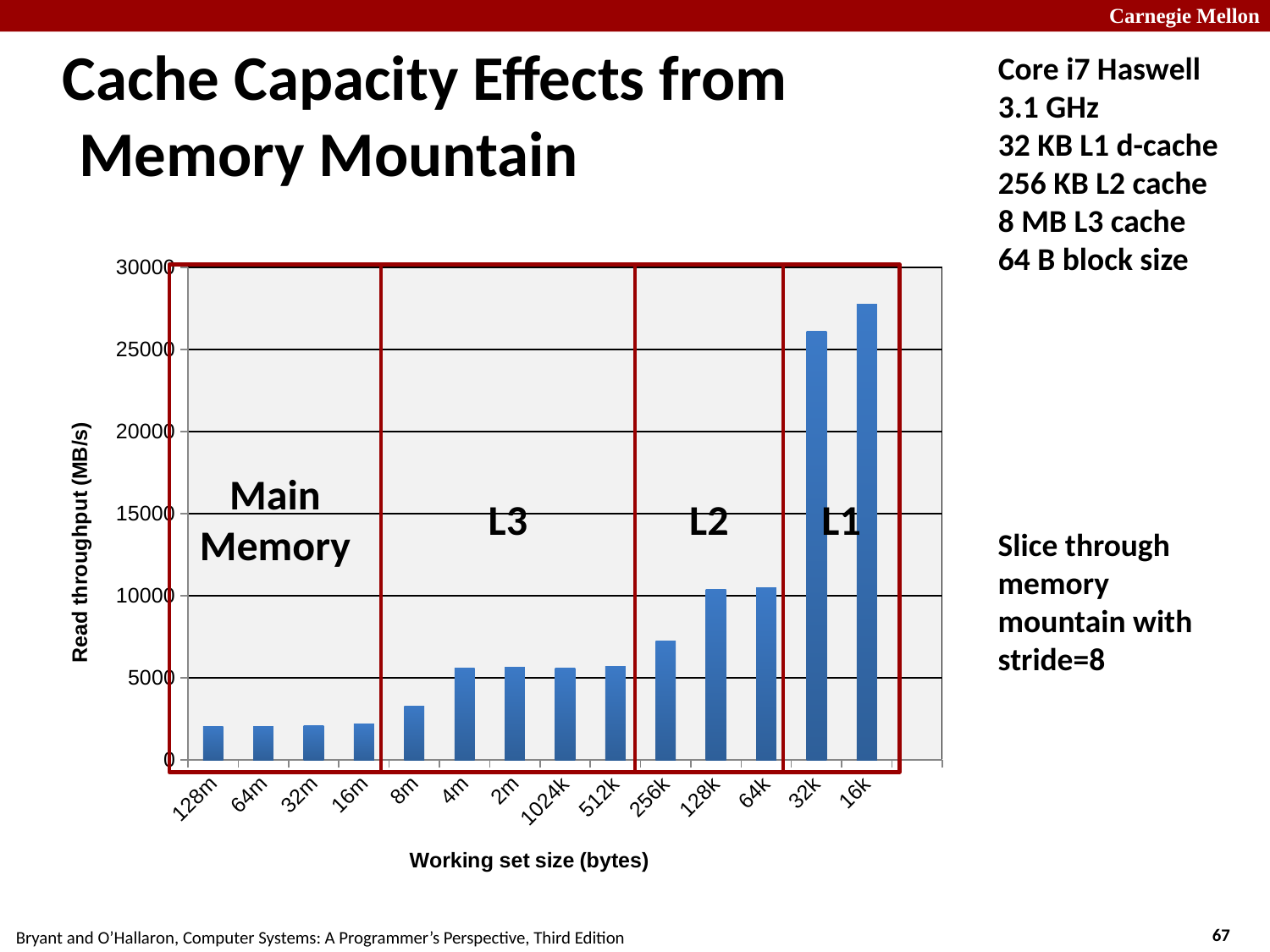
What kind of chart is shown on the slide? bar chart Which working set size has the highest read throughput? 16k Is the read throughput for a working set size of 16k greater or less than 25000 MB/s? greater Is the read throughput for a working set size of 128m greater or less than 5000 MB/s? less What are the four region labels written over the chart, from left to right? Main Memory, L3, L2, L1 Which has the higher read throughput: a working set size of 256k or 128k? 128k Is the read throughput for a working set size of 256k greater or less than 10000 MB/s? less Do the bars generally rise or fall moving from left (128m) to right (16k) along the x axis? rise What is the label of the y axis? Read throughput (MB/s) How many working set sizes (bars) are plotted on the chart? 14 Which has the higher read throughput: a working set size of 16k or 32k? 16k